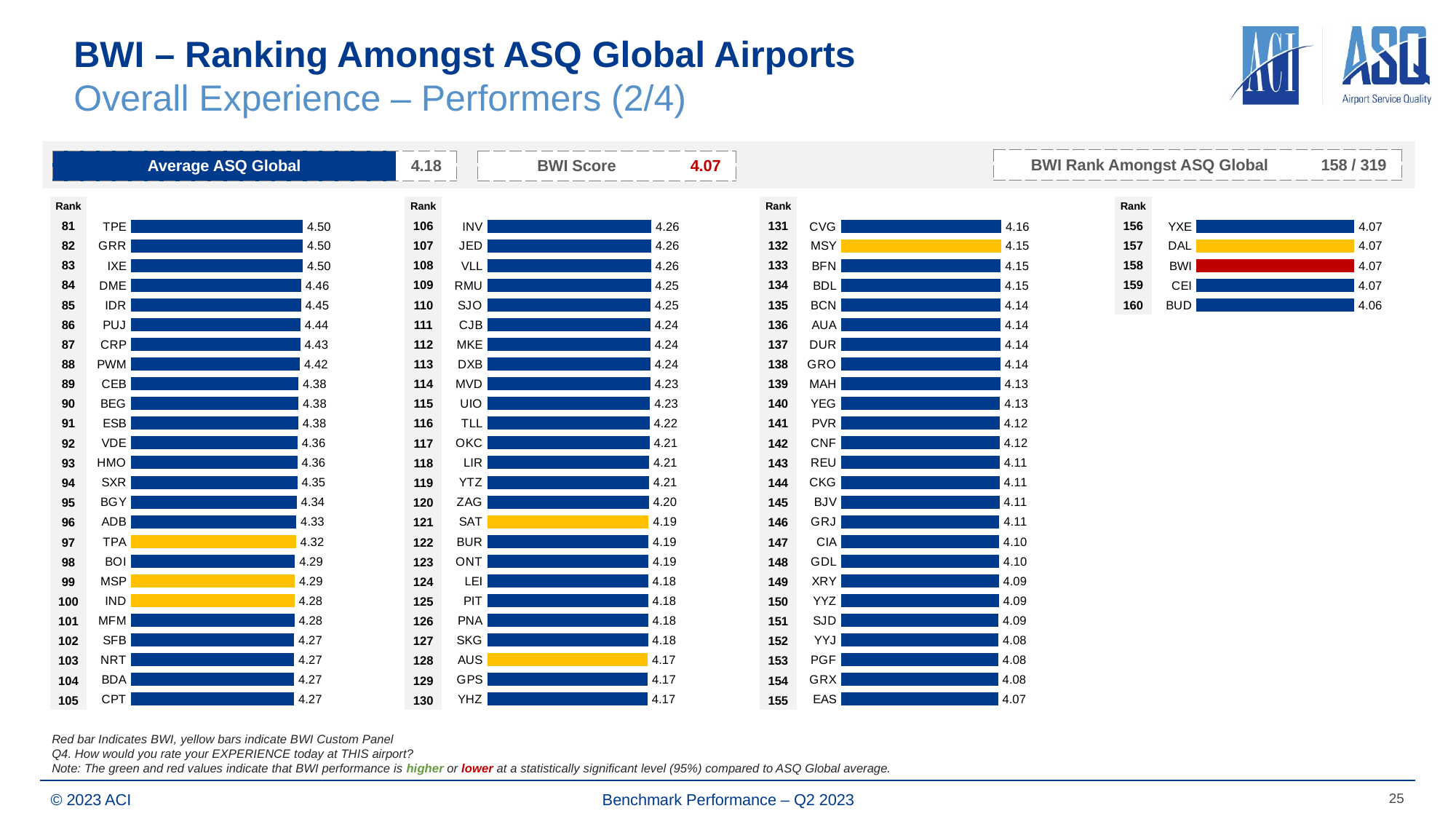
What kind of chart is used to show the airport scores on this slide? Bar chart How many airports are plotted in the leftmost chart (ranks 81–105)? 25 In the rightmost chart (ranks 156–160), which airport's bar is coloured red? BWI In the leftmost chart (ranks 81–105), what is the difference between the values for TPE and CPT? 0.23 In the second chart from the left (ranks 106–130), which airport has the highest value? INV, JED and VLL (all 4.26) In the rightmost chart (ranks 156–160), what is the value for BUD? 4.06 In the leftmost chart (ranks 81–105), which airport has the lowest value? SFB, NRT, BDA and CPT (all 4.27) In the third chart from the left (ranks 131–155), which is larger, the value for CVG or the value for EAS? CVG In the second chart from the left (ranks 106–130), what is the value for SAT? 4.19 How many airports are plotted in the rightmost chart (ranks 156–160)? 5 In the third chart from the left (ranks 131–155), what is the value for MSY? 4.15 In the leftmost chart (ranks 81–105), what is the value for TPE? 4.50